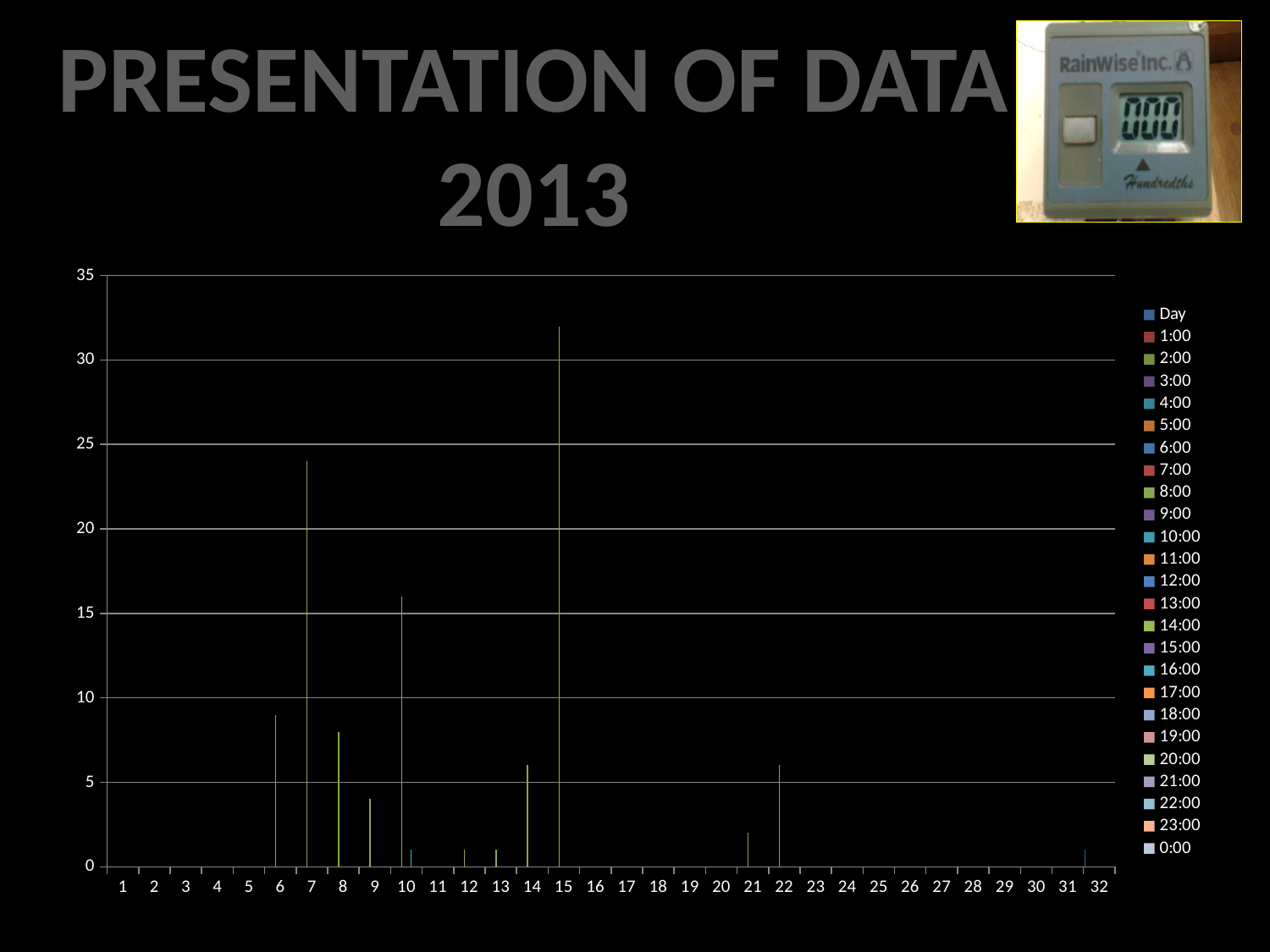
How many series does the chart's legend list? 25 What kind of chart is shown on the slide? bar chart Is the value for category 6 greater or less than 10? less Is the value for category 7 greater or less than 20? greater Which x-axis category has the tallest bar in the chart? 15 What is the highest value shown on the chart's y axis? 35 Is the value for category 7 greater or less than 25? less Which has the larger value, category 7 or category 10? 7 How many categories are labelled along the x axis of the chart? 32 Which has the larger value, category 15 or category 7? 15